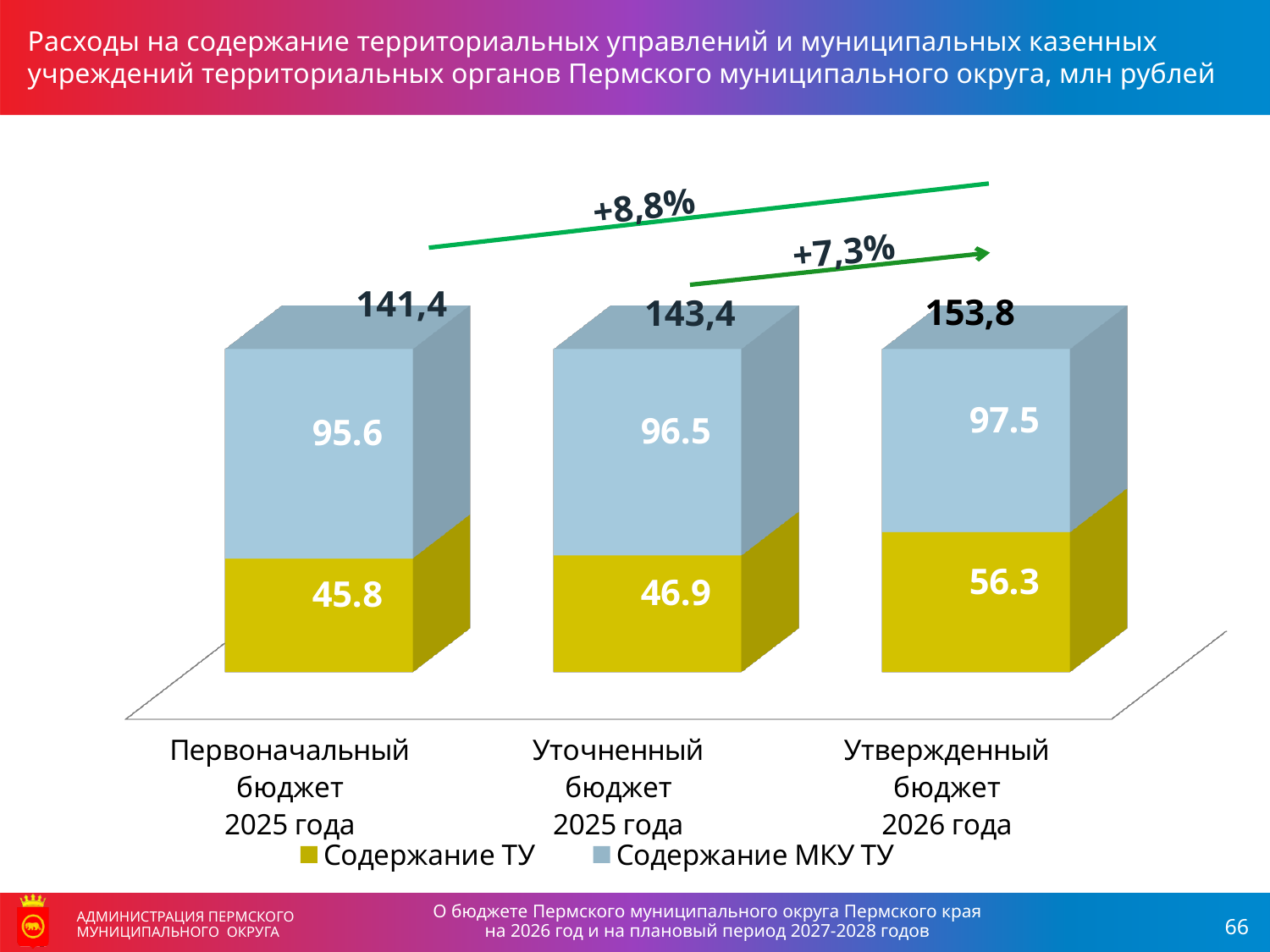
What is the total printed above the bar for Первоначальный бюджет 2025 года? 141,4 What is the difference in Содержание ТУ between Утвержденный бюджет 2026 года and Уточненный бюджет 2025 года? 9.4 What is the value of Содержание МКУ ТУ for Утвержденный бюджет 2026 года? 97.5 What is the total printed above the bar for Утвержденный бюджет 2026 года? 153,8 Which is larger: Содержание ТУ for Уточненный бюджет 2025 года or Содержание ТУ for Первоначальный бюджет 2025 года? Уточненный бюджет 2025 года What is the value of Содержание ТУ for Первоначальный бюджет 2025 года? 45.8 What kind of chart is shown on the slide? Stacked bar chart How many series does the legend list? 2 How many categories are shown on the x axis? 3 What is the value of Содержание МКУ ТУ for Уточненный бюджет 2025 года? 96.5 Which category has the lowest value for Содержание МКУ ТУ? Первоначальный бюджет 2025 года Which category has the highest value for Содержание ТУ? Утвержденный бюджет 2026 года